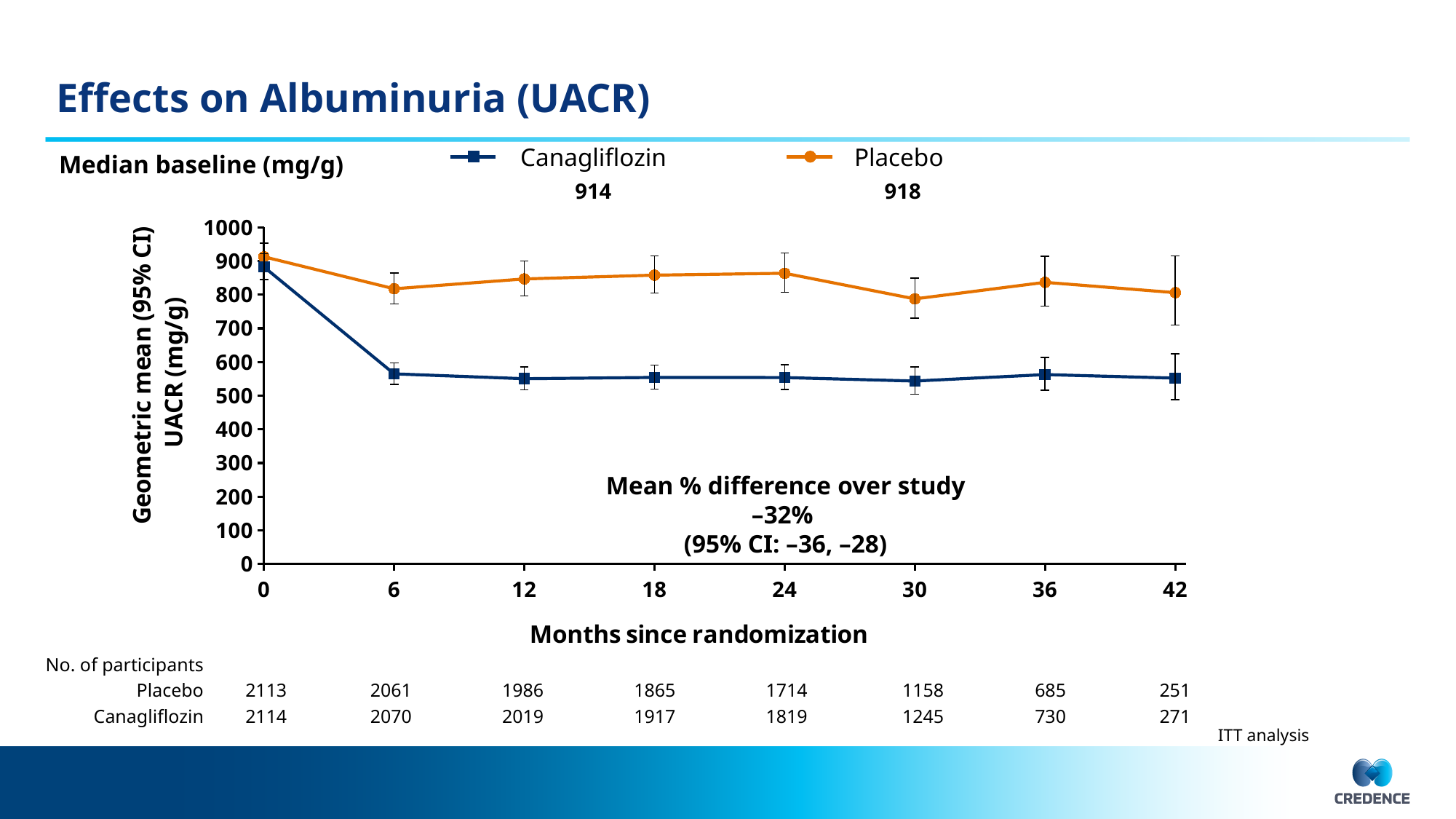
Is the Placebo value at 24 months greater or less than 800? greater What is the median baseline UACR (mg/g) for Canagliflozin? 914 What is the median baseline UACR (mg/g) for Placebo? 918 What kind of chart is shown on the slide? line chart How many Placebo participants are listed at 42 months? 251 How many series does the legend list? 2 How many time points are plotted along the x axis? 8 How many Canagliflozin participants are listed at 0 months? 2114 Does the Canagliflozin line rise or fall between 0 and 6 months? fall What is the mean % difference over the study shown on the chart? –32% At 12 months, which series has the higher UACR value, Canagliflozin or Placebo? Placebo Is the Canagliflozin value at 6 months greater or less than 600? less